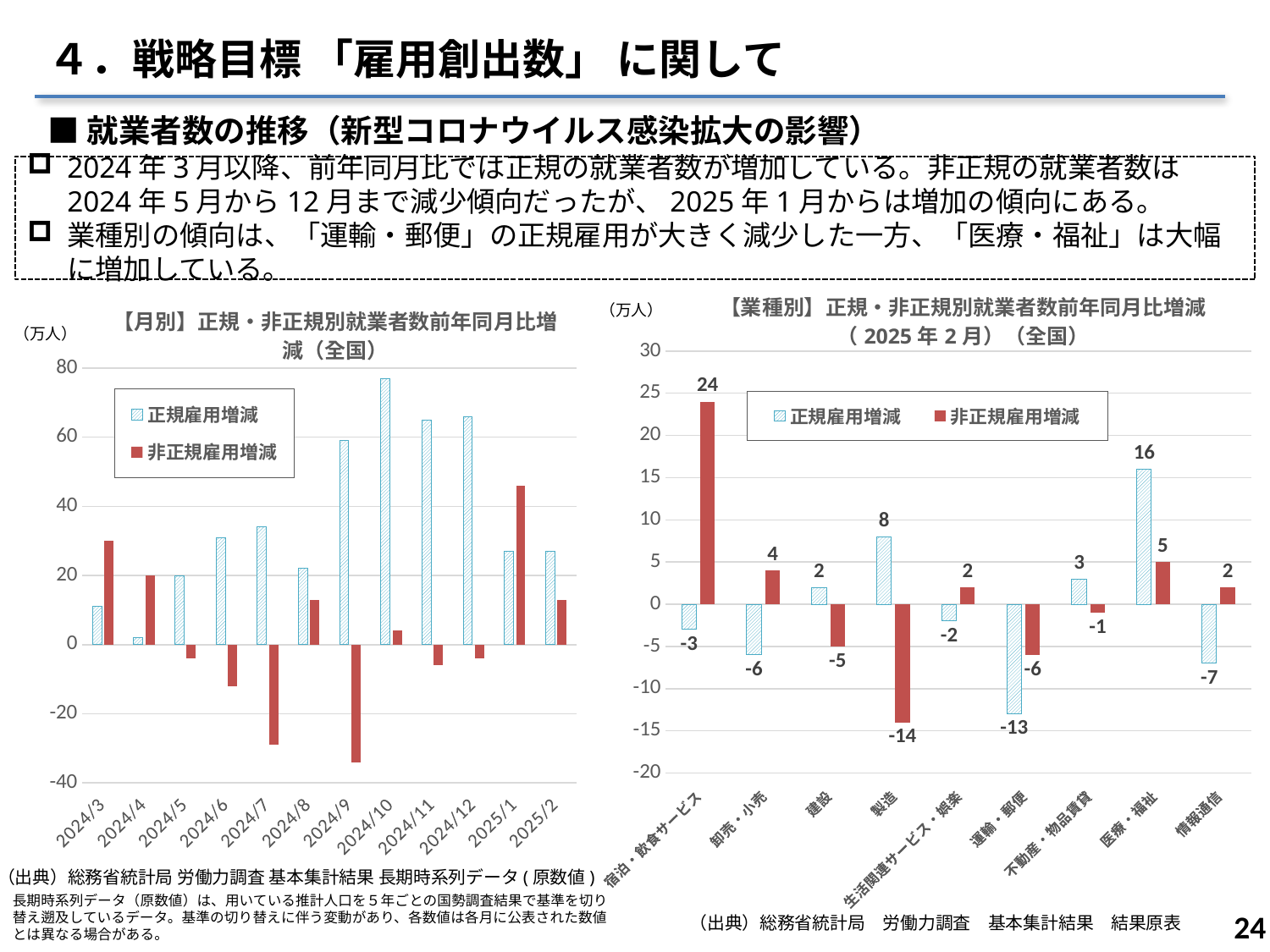
In the 【業種別】 chart on the right, what is the difference between the 正規雇用増減 values for 医療・福祉 and 製造? 8 In the 【業種別】 chart on the right, which industry has the highest 正規雇用増減 value? 医療・福祉 How many series does the legend of the 【月別】 chart on the left list? 2 In the 【業種別】 chart on the right, what is the 正規雇用増減 value for 運輸・郵便? -13 In the 【業種別】 chart on the right, which industry has the lowest 非正規雇用増減 value? 製造 In the 【業種別】 chart on the right, what is the 正規雇用増減 value for 医療・福祉? 16 What kind of chart is the 【月別】 chart on the left? Bar chart How many months are shown on the x axis of the 【月別】 chart on the left? 12 In the 【業種別】 chart on the right, what is the 非正規雇用増減 value for 宿泊・飲食サービス? 24 In the 【月別】 chart on the left, is the 正規雇用増減 value for 2024/10 greater or less than 60? greater How many industries are shown on the x axis of the 【業種別】 chart on the right? 9 In the 【業種別】 chart on the right, which is larger: the 正規雇用増減 for 建設 or the 正規雇用増減 for 不動産・物品賃貸? 不動産・物品賃貸